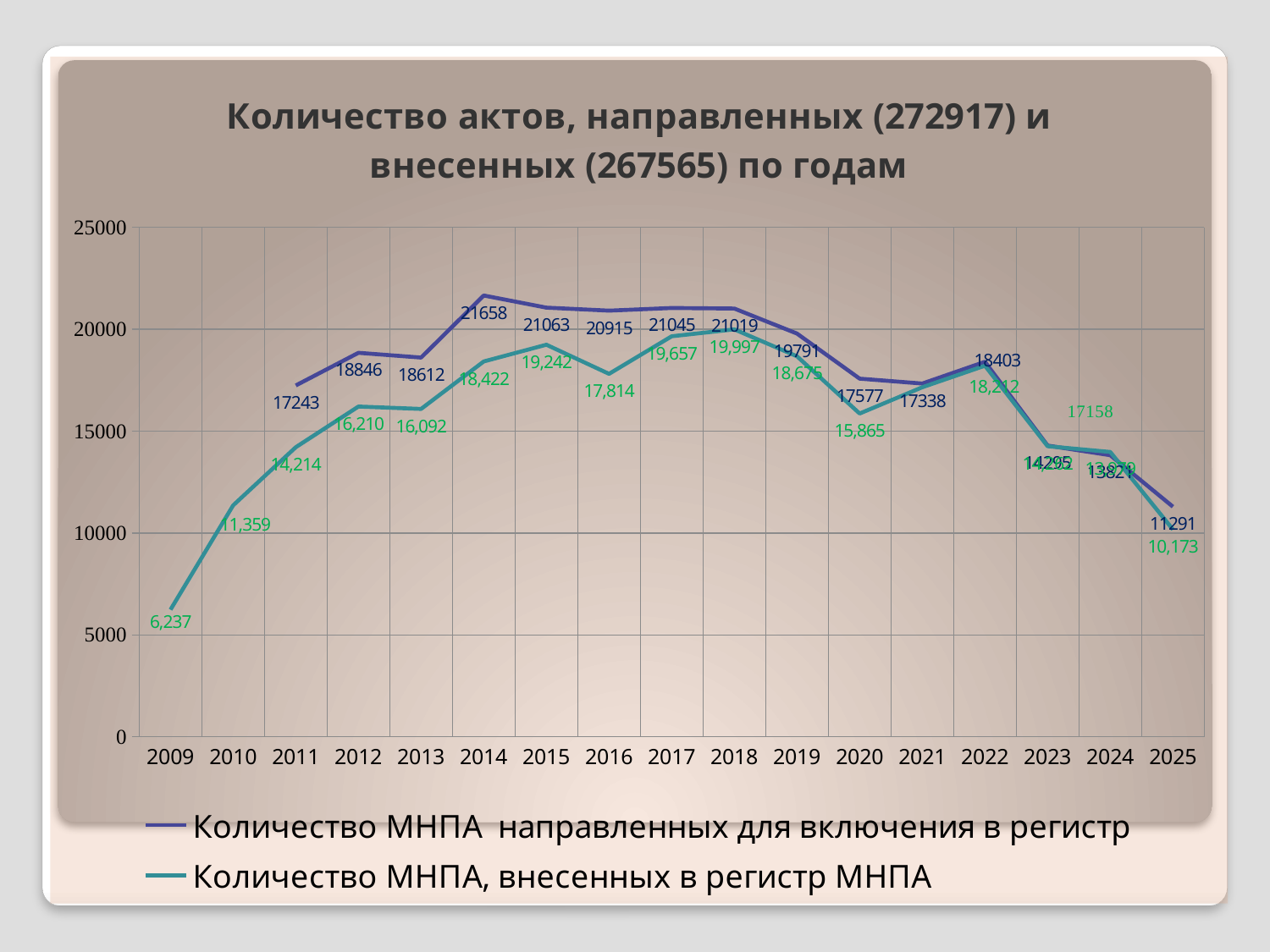
In which year is 'Количество МНПА направленных для включения в регистр' highest? 2014 How many series does the legend list? 2 What is the value of 'Количество МНПА, внесенных в регистр МНПА' for 2009? 6,237 In which year is 'Количество МНПА, внесенных в регистр МНПА' lowest? 2009 What is the difference between the two series in 2014 (направленных minus внесенных)? 3236 How many years are shown on the x axis? 17 What is the value of 'Количество МНПА, внесенных в регистр МНПА' for 2025? 10,173 What kind of chart is shown on the slide? line chart Does 'Количество МНПА направленных для включения в регистр' rise or fall from 2022 to 2025? fall What is the title of the chart? Количество актов, направленных (272917) и внесенных (267565) по годам In 2016, which series has the larger value: направленных or внесенных? направленных (20915) What is the value of 'Количество МНПА направленных для включения в регистр' for 2014? 21658